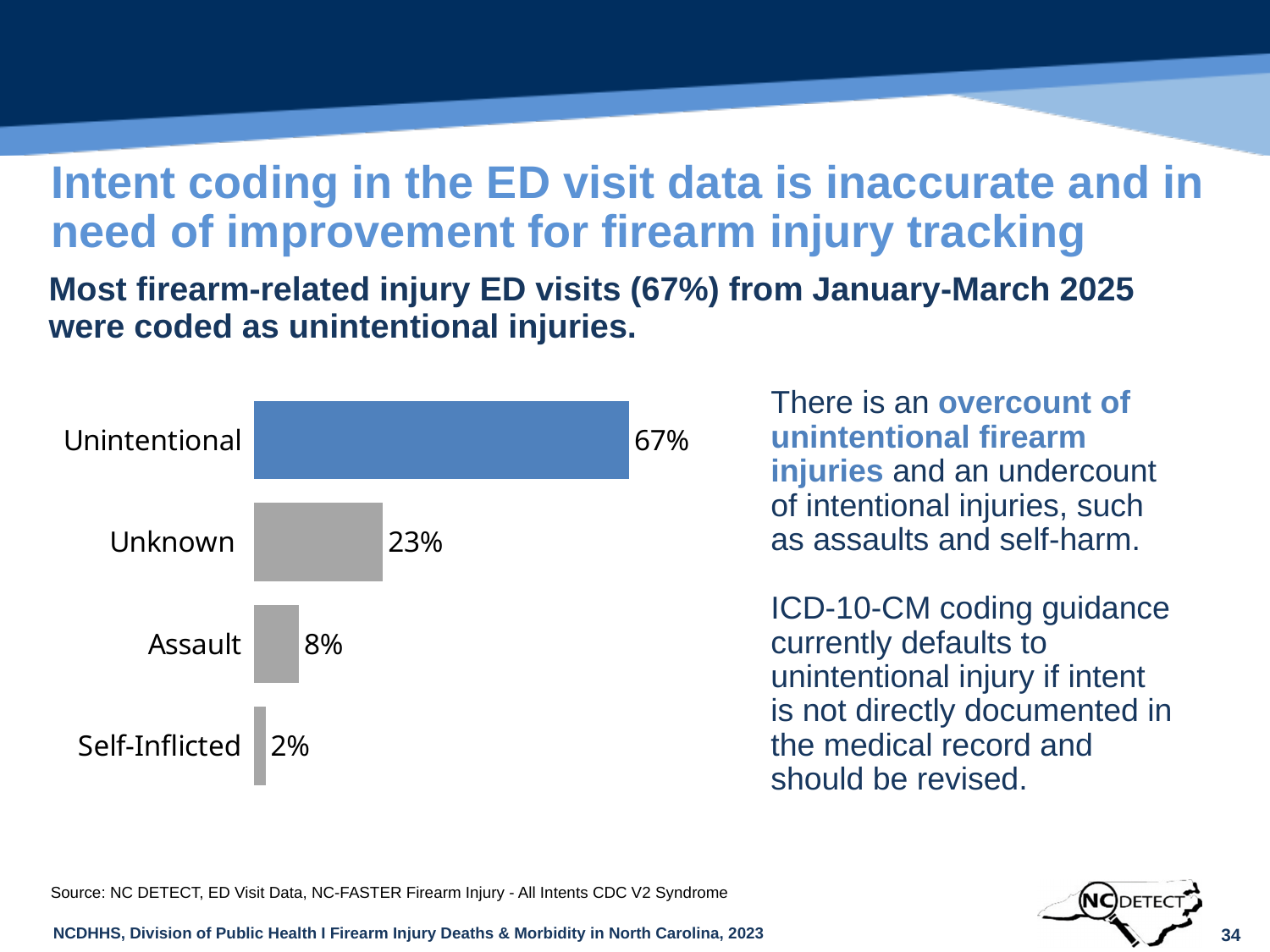
Which intent category has the highest share of firearm-related injury ED visits? Unintentional Which category has a larger share: Unknown or Assault? Unknown What percentage of firearm-related injury ED visits were coded as Unintentional? 67% Which intent category has the lowest share of firearm-related injury ED visits? Self-Inflicted What percentage of firearm-related injury ED visits were coded as Self-Inflicted? 2% What percentage of firearm-related injury ED visits were coded as Unknown intent? 23% How many intent categories are shown in the chart? 4 What is the difference in percentage points between the Assault and Self-Inflicted categories? 6 percentage points What type of chart is used to show the intent coding of firearm-related injury ED visits? Bar chart What percentage of firearm-related injury ED visits were coded as Assault? 8% What is the difference in percentage points between the Unintentional and Unknown categories? 44 percentage points Which bar in the chart is coloured blue rather than grey? Unintentional